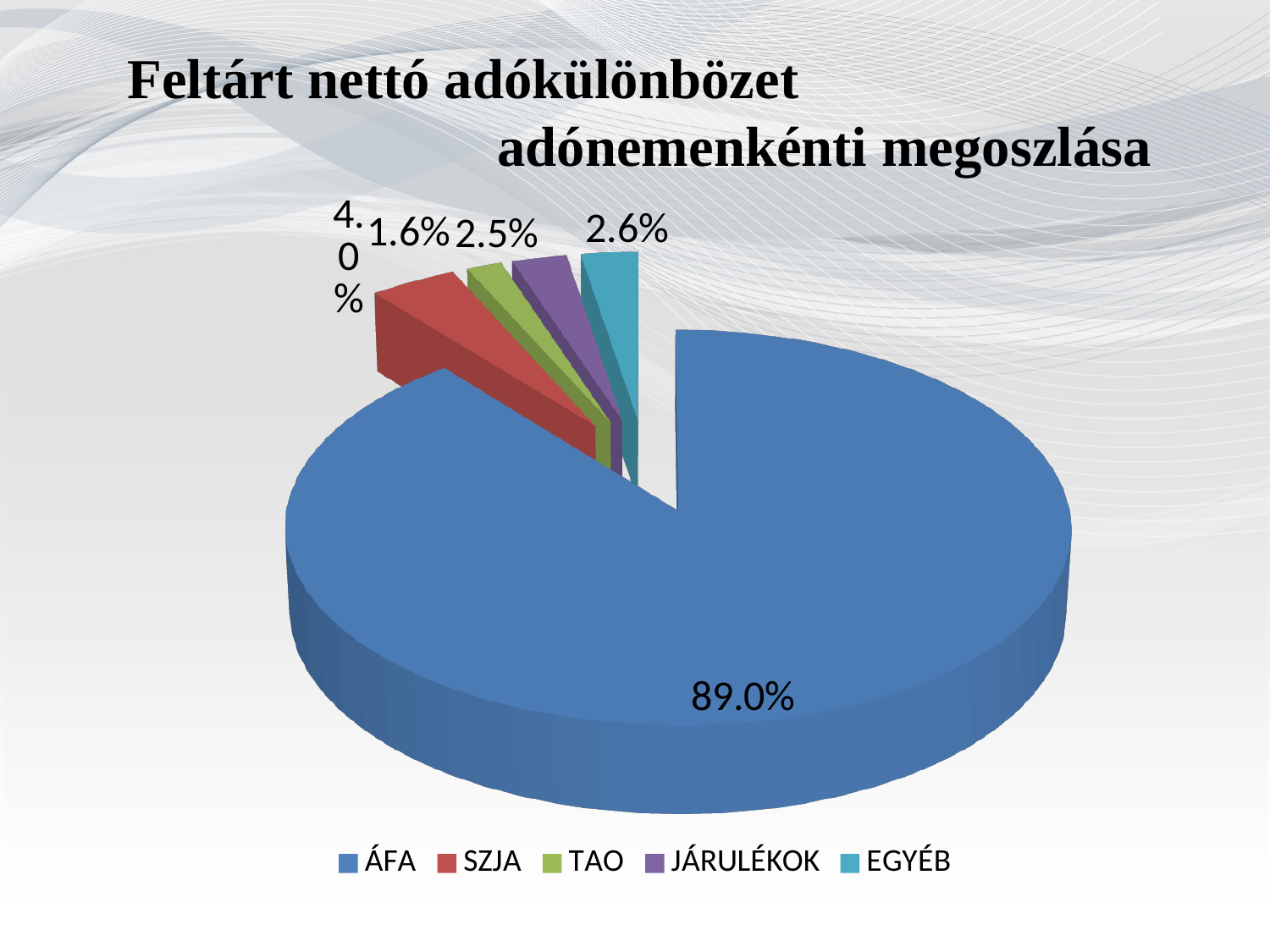
Which category has the smallest slice of the pie? TAO What colour is the ÁFA slice in the pie chart? Blue What percentage is shown for JÁRULÉKOK? 2.5% What percentage is shown for SZJA? 4.0% What percentage is shown for TAO? 1.6% What kind of chart is shown on the slide? Pie chart What is the difference between the share for ÁFA and the share for SZJA? 85.0% Which is larger, the share for SZJA or the share for TAO? SZJA Which category has the largest slice of the pie? ÁFA What percentage is shown for EGYÉB? 2.6% How many categories does the pie chart show? 5 What share of the pie does ÁFA have? 89.0%